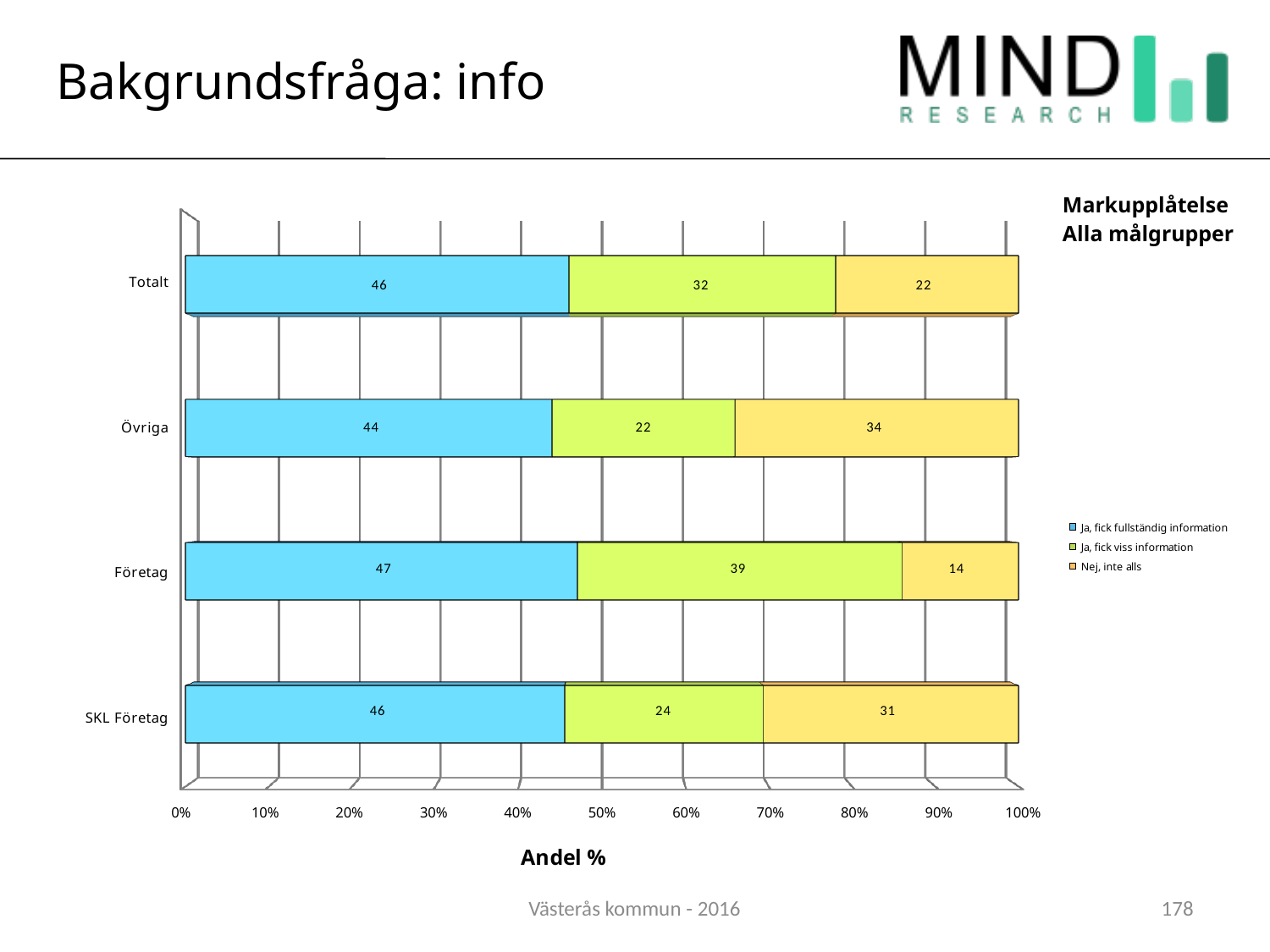
How many series does the legend list? 3 What is the difference between the "Ja, fick viss information" values for Företag and Totalt? 7 What is the value for "Ja, fick fullständig information" in the Företag bar? 47 Which category has the highest value for "Nej, inte alls"? Övriga Which is larger: the "Nej, inte alls" value for SKL Företag or for Totalt? SKL Företag What is the value for "Ja, fick viss information" in the SKL Företag bar? 24 What is the value for "Ja, fick viss information" in the Totalt bar? 32 What is the label of the horizontal axis of the chart? Andel % What is the value for "Nej, inte alls" in the Övriga bar? 34 What kind of chart is shown on the slide? Stacked bar chart Which category has the lowest value for "Ja, fick viss information"? Övriga How many categories are shown on the vertical axis of the chart? 4